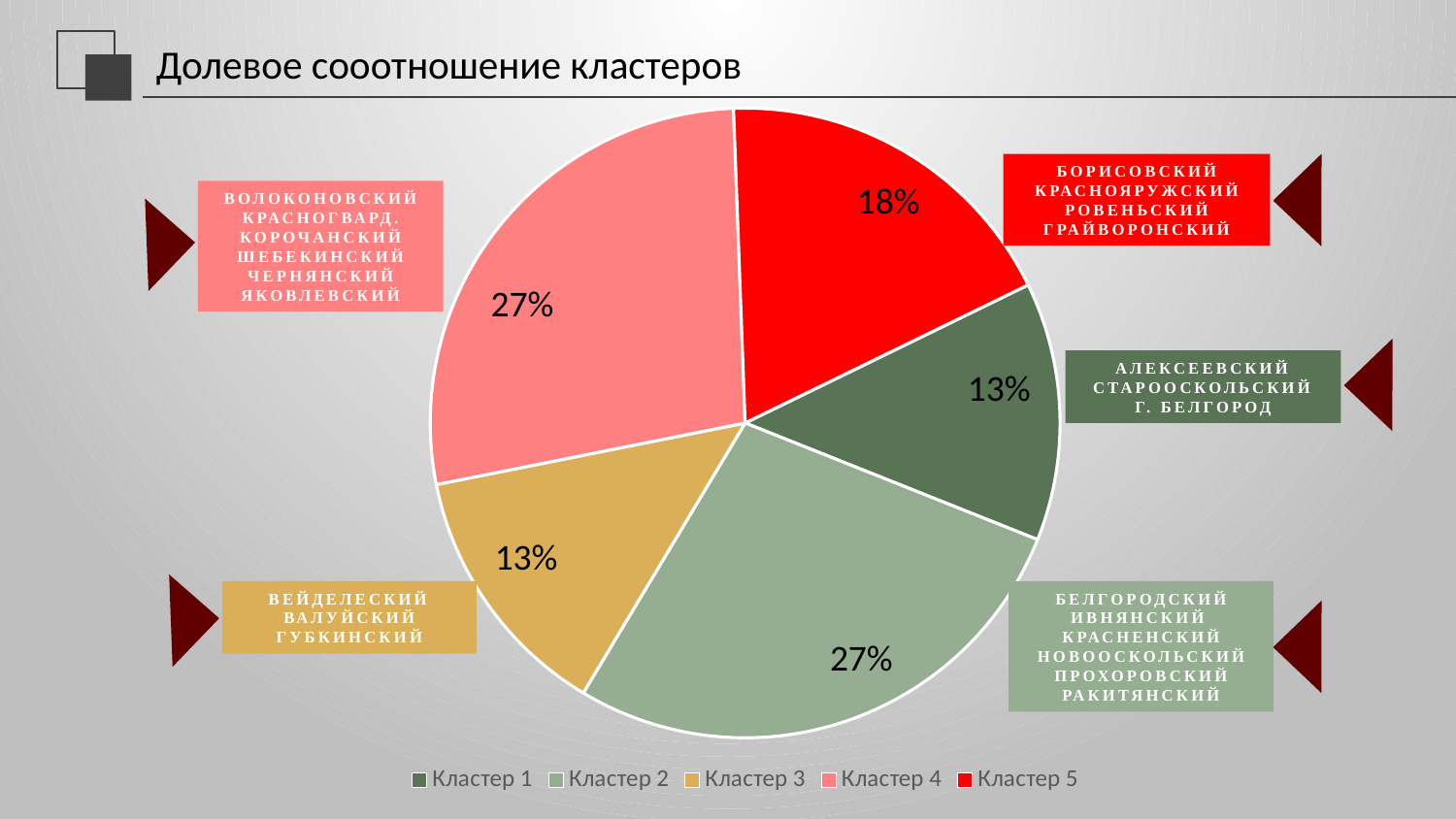
What share of the pie does Кластер 1 have? 13% What is the difference in percentage points between the share of Кластер 2 and the share of Кластер 5? 9 What share of the pie does Кластер 2 have? 27% Which is larger, the share of Кластер 5 or the share of Кластер 1? Кластер 5 What type of chart is shown on the slide? Pie chart What share of the pie does Кластер 3 have? 13% What colour is the slice for Кластер 5 in the legend? Red How many entries does the legend list? 5 What is the title of the chart? Долевое сооотношение кластеров What share of the pie does Кластер 4 have? 27% How many slices does the pie chart have? 5 What share of the pie does Кластер 5 have? 18%